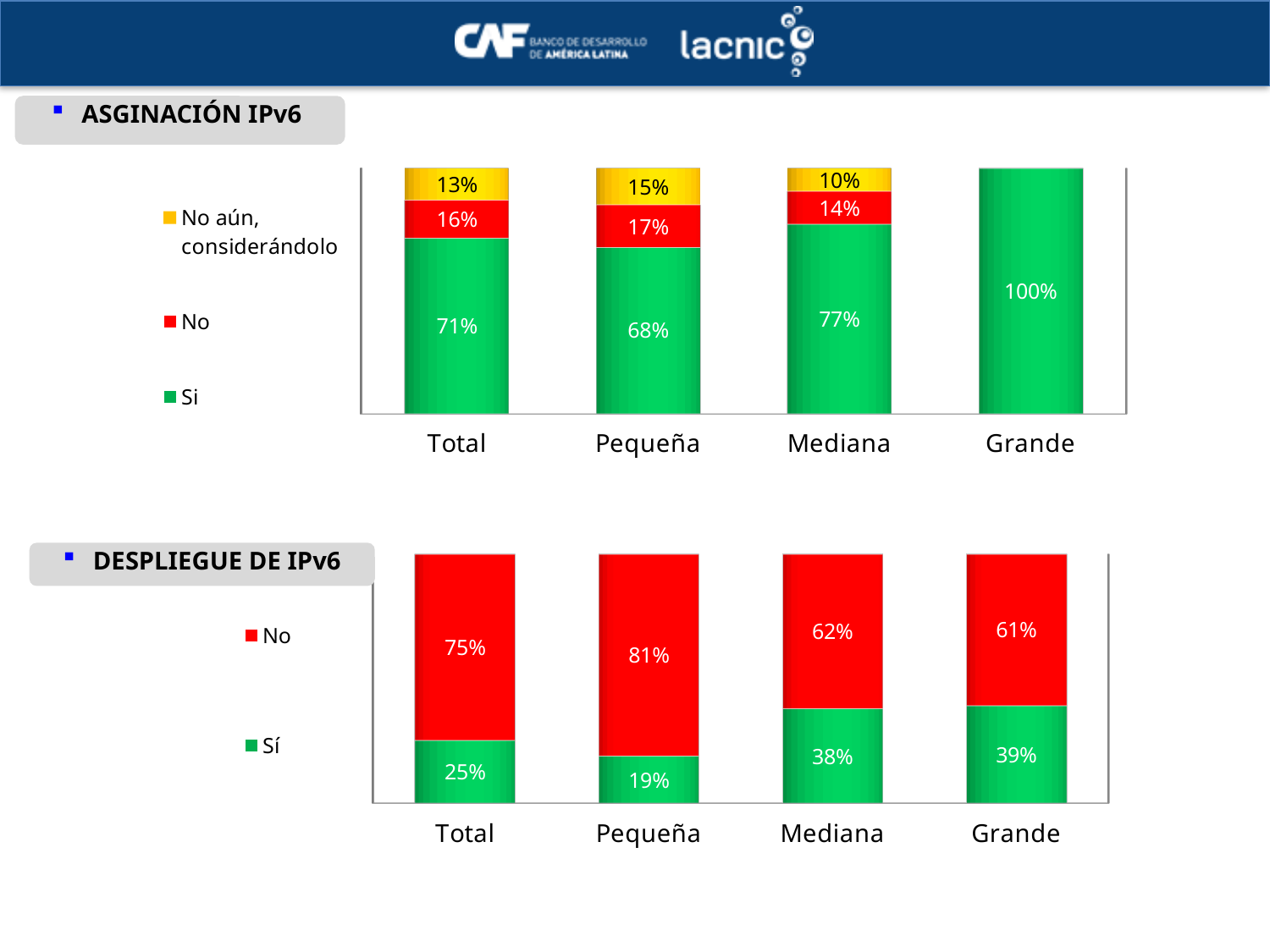
In the DESPLIEGUE DE IPv6 chart, what is the difference between the 'Sí' values for Grande and Total? 14% In the ASGINACIÓN IPv6 chart, how many series does the legend list? 3 In the ASGINACIÓN IPv6 chart, what is the difference between the 'No' values for Pequeña and Mediana? 3% In the DESPLIEGUE DE IPv6 chart, which is larger, the 'No' value for Total or the 'No' value for Mediana? Total In the ASGINACIÓN IPv6 chart, what is the value of 'Si' for Mediana? 77% In the ASGINACIÓN IPv6 chart, what is the value of 'No aún, considerándolo' for Pequeña? 15% In the DESPLIEGUE DE IPv6 chart, what is the value of 'Sí' for Pequeña? 19% In the DESPLIEGUE DE IPv6 chart, which category has the lowest 'Sí' value? Pequeña What kind of chart is the DESPLIEGUE DE IPv6 chart? Stacked bar chart In the DESPLIEGUE DE IPv6 chart, what is the value of 'No' for Grande? 61% In the ASGINACIÓN IPv6 chart, which category has the highest 'Si' value? Grande In the DESPLIEGUE DE IPv6 chart, how many categories are shown on the x axis? 4